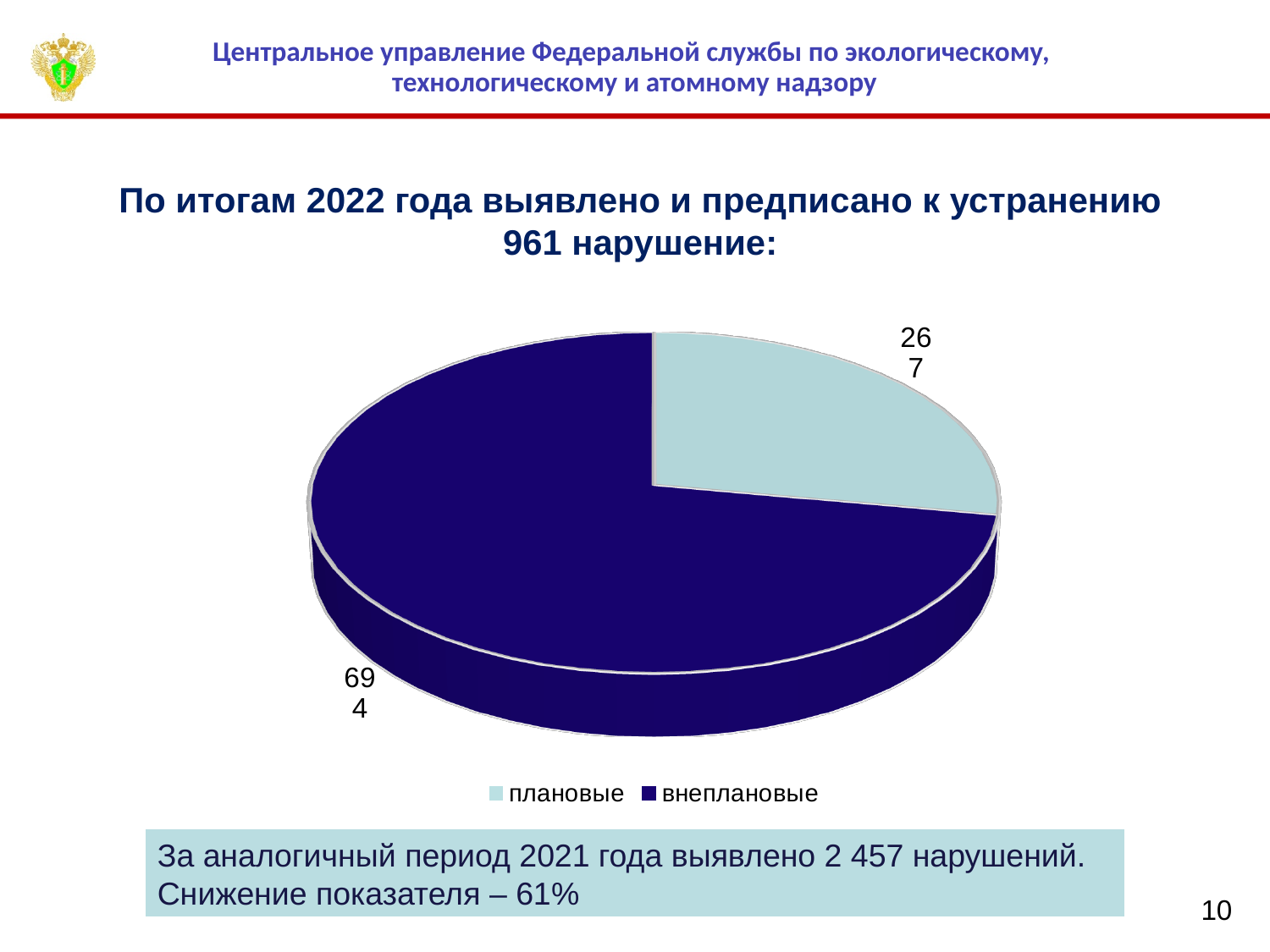
What value is shown for the внеплановые slice of the pie chart? 694 What kind of chart is shown on the slide? Pie chart What is the difference between the внеплановые and плановые values in the pie chart? 427 Which colour represents плановые in the pie chart? Light blue Which is larger in the pie chart, плановые or внеплановые? внеплановые How many entries does the legend of the pie chart list? 2 Which category has the largest slice in the pie chart? внеплановые What is the total of the two slices in the pie chart? 961 What value is shown for the плановые slice of the pie chart? 267 How many slices does the pie chart have? 2 Which category has the smallest slice in the pie chart? плановые Which colour represents внеплановые in the pie chart? Dark blue